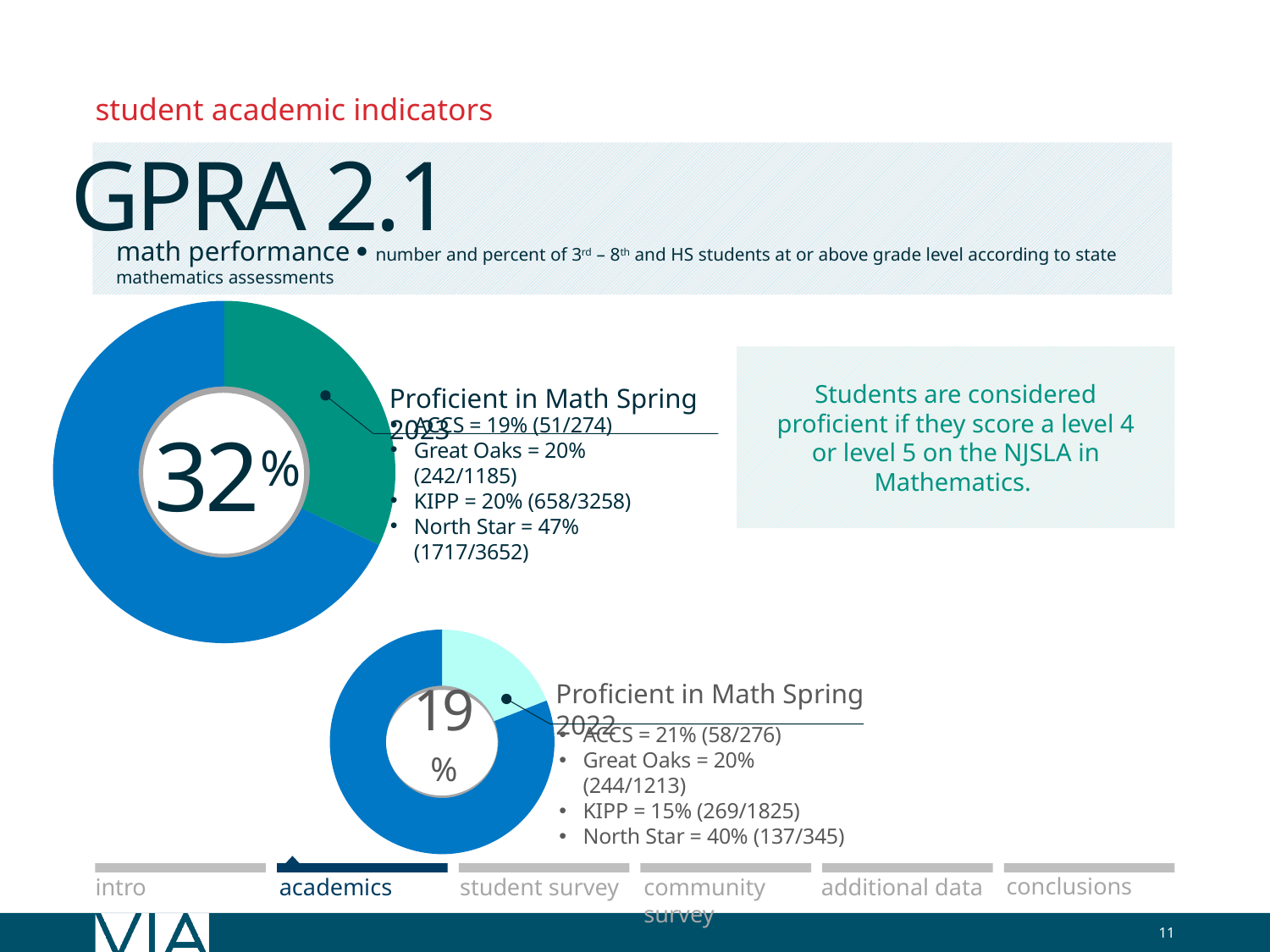
What percentage is shown in the center of the larger donut chart labeled Proficient in Math Spring 2023? 32% What colour is the highlighted segment in the Proficient in Math Spring 2023 donut chart? Green How many segments does the Proficient in Math Spring 2022 donut chart have? 2 Did the overall math proficiency percentage shown in the donut charts rise or fall from Spring 2022 to Spring 2023? Rise What colour is the highlighted segment in the Proficient in Math Spring 2022 donut chart? Light cyan What is the difference in percentage points between the Spring 2023 donut chart value and the Spring 2022 donut chart value? 13 percentage points What percentage is shown in the center of the smaller donut chart labeled Proficient in Math Spring 2022? 19% Which chart shows the higher proficiency percentage, Proficient in Math Spring 2023 or Proficient in Math Spring 2022? Proficient in Math Spring 2023 What kind of chart is used to show the Proficient in Math Spring 2023 value? Donut (pie) chart How many segments does the Proficient in Math Spring 2023 donut chart have? 2 In the Proficient in Math Spring 2023 donut chart, does the highlighted (green) segment represent more or less than half of the ring? Less